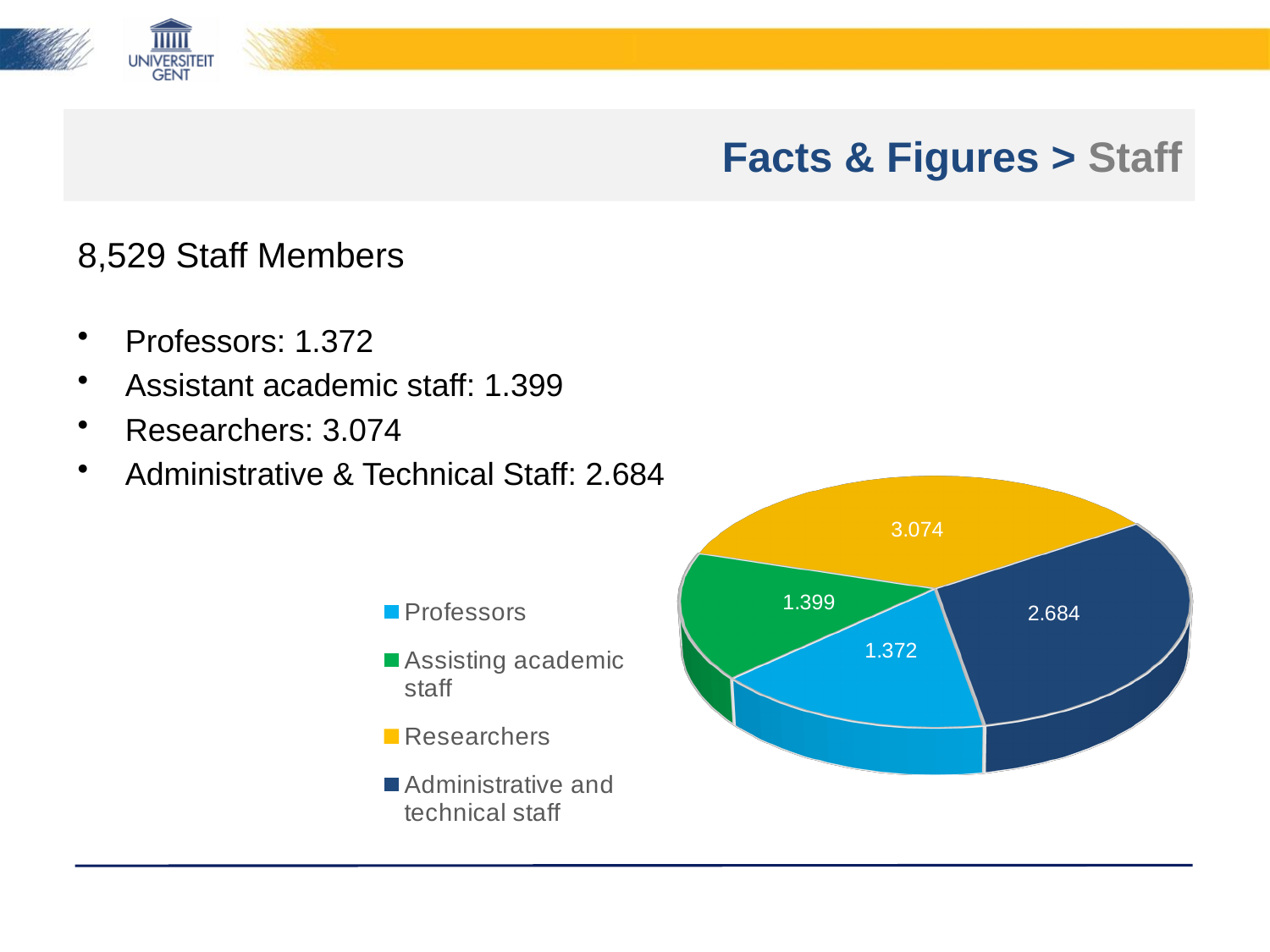
Which is larger in the pie chart: Researchers or Administrative and technical staff? Researchers What colour is the Researchers slice in the pie chart? yellow What is the value shown for Administrative and technical staff in the pie chart? 2.684 Which category has the largest slice in the pie chart? Researchers What is the difference between the Researchers value and the Administrative and technical staff value in the pie chart? 390 What is the value shown for Researchers in the pie chart? 3.074 What is the value shown for Assisting academic staff in the pie chart? 1.399 What is the value shown for Professors in the pie chart? 1.372 How many entries does the legend of the pie chart list? 4 What type of chart is shown on the slide? pie chart Which category has the smallest slice in the pie chart? Professors How many slices does the pie chart have? 4